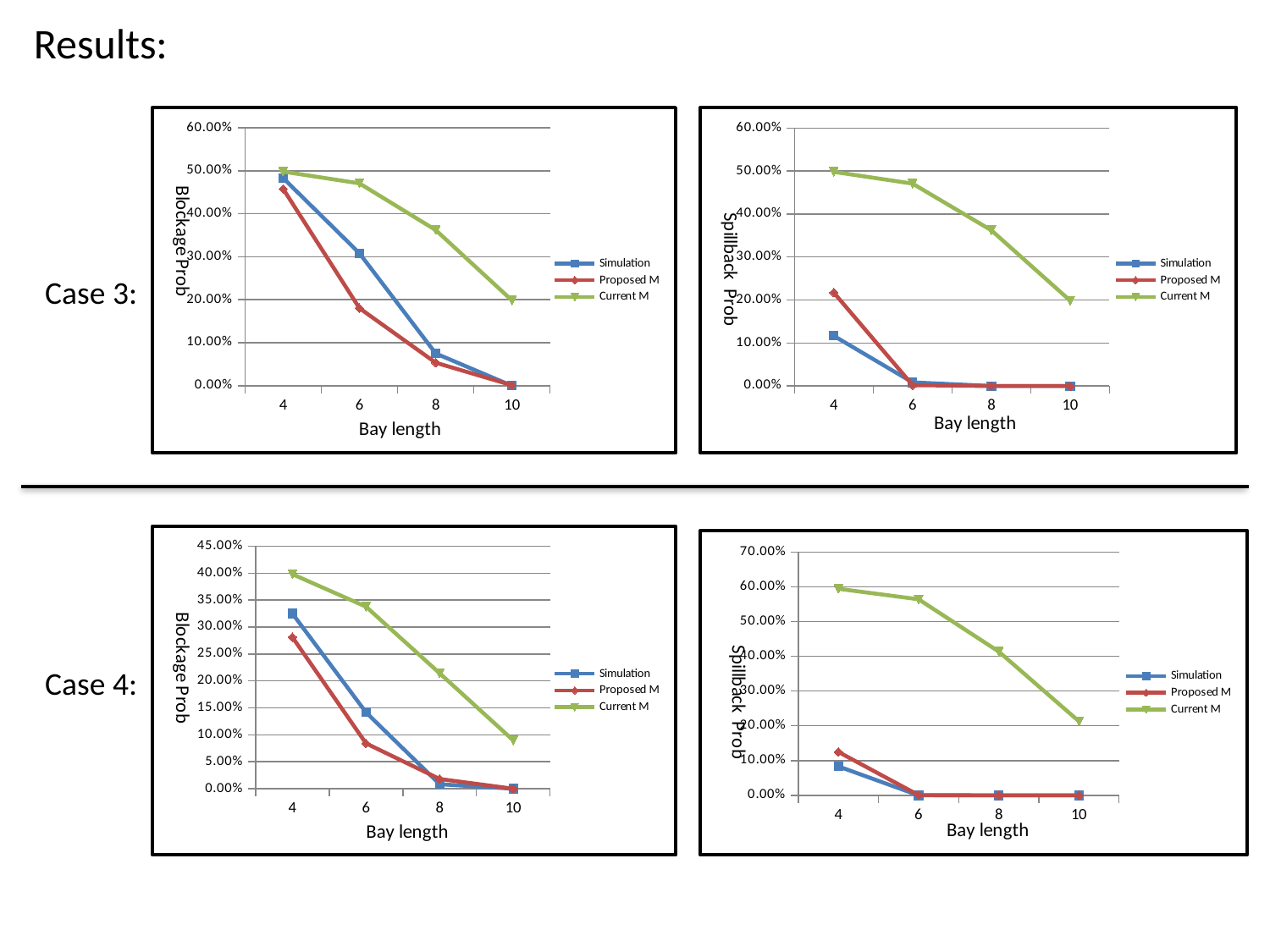
In the Case 3 Blockage Prob chart (top left), is the Simulation value at bay length 6 greater or less than 20.00%? greater What kind of chart is the Case 3 Blockage Prob chart (top left)? line chart How many series does the legend of the Case 3 Spillback Prob chart (top right) list? 3 In the Case 4 Spillback Prob chart (bottom right), is the Current M value at bay length 8 greater or less than 30.00%? greater In the Case 4 Blockage Prob chart (bottom left), is the Proposed M value at bay length 6 greater or less than 10.00%? less In the Case 3 Spillback Prob chart (top right), which series has the lowest value at bay length 4? Simulation How many bay length values are plotted on the x axis of the Case 4 Blockage Prob chart (bottom left)? 4 What is the x-axis title of the Case 4 Spillback Prob chart (bottom right)? Bay length In the Case 4 Blockage Prob chart (bottom left), which series has the highest value at bay length 4? Current M In the Case 4 Spillback Prob chart (bottom right), does the Current M series rise or fall as bay length increases? fall In the Case 3 Spillback Prob chart (top right), which is larger at bay length 4: Proposed M or Simulation? Proposed M